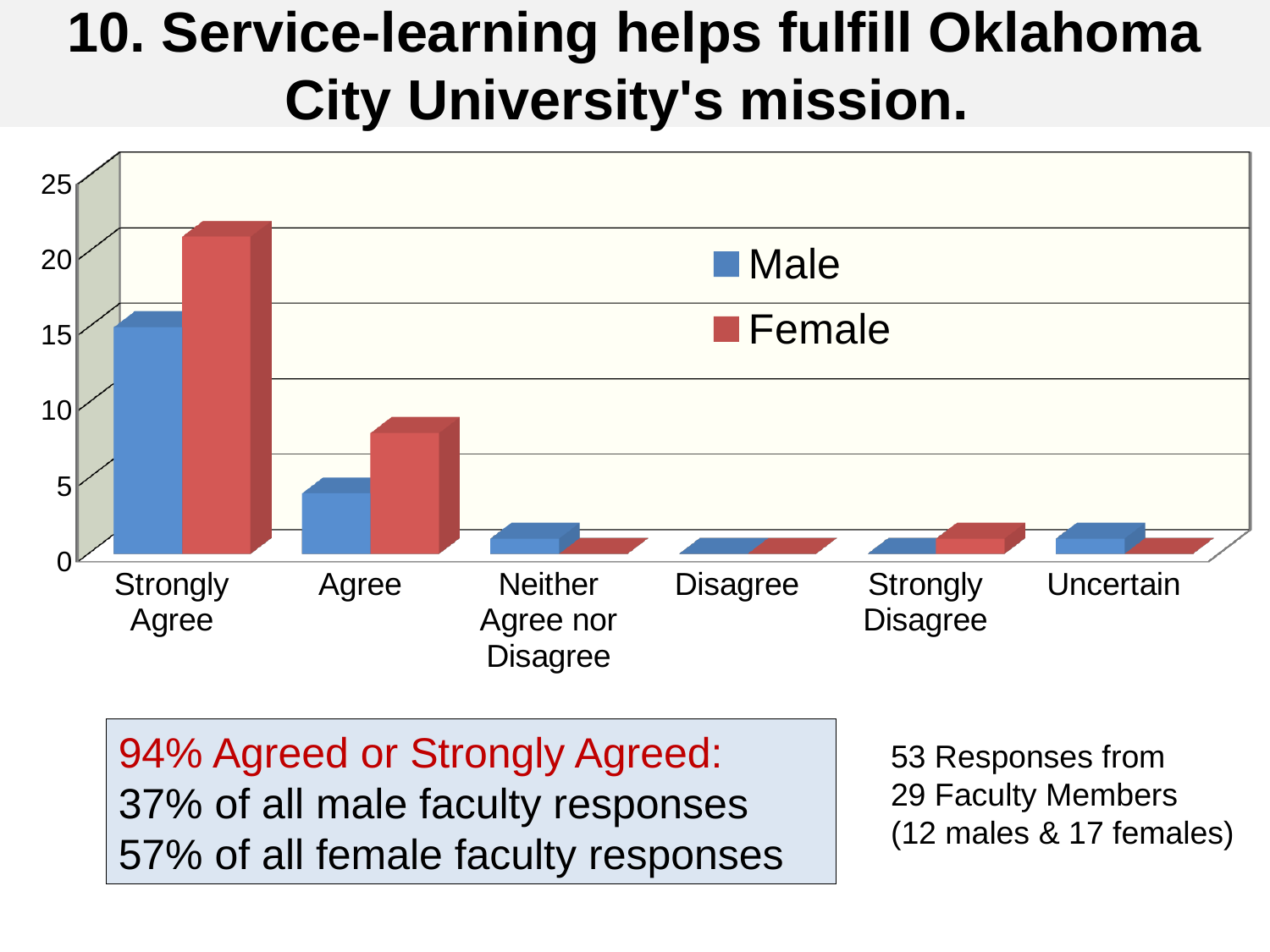
Is the Female value for Strongly Agree greater or less than 20? greater Which colour represents the Female series in the chart? red Is the Female value for Agree greater or less than 10? less Which category has the highest Male value? Strongly Agree Which category has the highest Female value? Strongly Agree How many series does the legend list? 2 Is the Male value for Agree greater or less than 5? less For Agree, which series has the larger value, Male or Female? Female For Strongly Agree, which series has the larger value, Male or Female? Female How many response categories are shown on the x axis? 6 What kind of chart is shown on the slide? bar chart